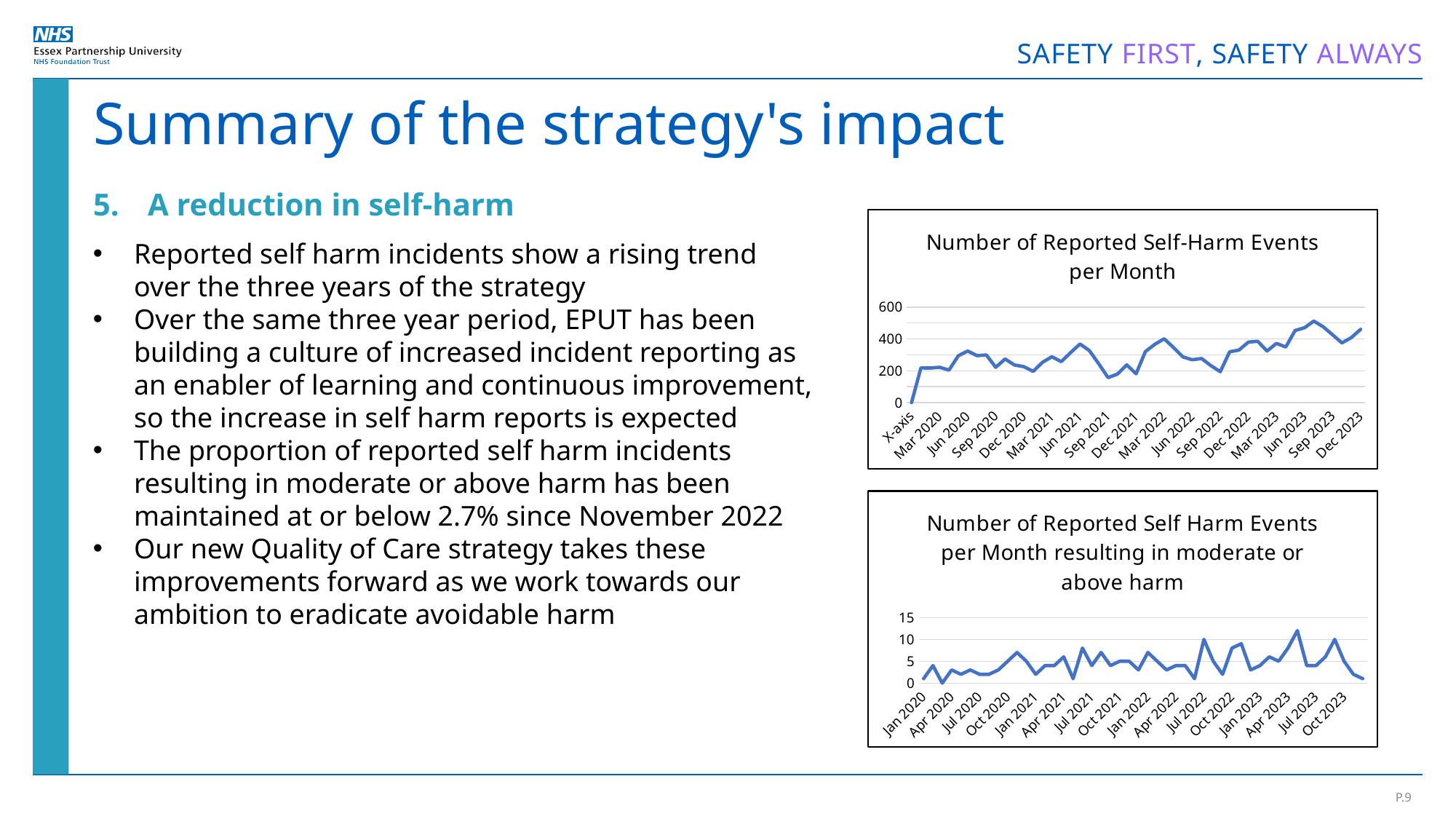
What type of chart is the top chart titled 'Number of Reported Self-Harm Events per Month'? Line chart What is the highest value shown on the y axis of the top chart 'Number of Reported Self-Harm Events per Month'? 600 What type of chart is the bottom chart about events resulting in moderate or above harm? Line chart In the top chart 'Number of Reported Self-Harm Events per Month', is the value for Sep 2021 greater or less than 200? less In the top chart 'Number of Reported Self-Harm Events per Month', is the value for Jun 2023 greater or less than 400? greater What is the highest value shown on the y axis of the bottom chart about moderate or above harm? 15 In the bottom chart about moderate or above harm, is the value for Jan 2020 greater or less than 5? less In the top chart 'Number of Reported Self-Harm Events per Month', which is larger, the value for Jun 2023 or the value for Sep 2021? Jun 2023 In the top chart 'Number of Reported Self-Harm Events per Month', do the values generally rise or fall from 2020 to 2023? Rise How many data series are plotted in the top chart 'Number of Reported Self-Harm Events per Month'? 1